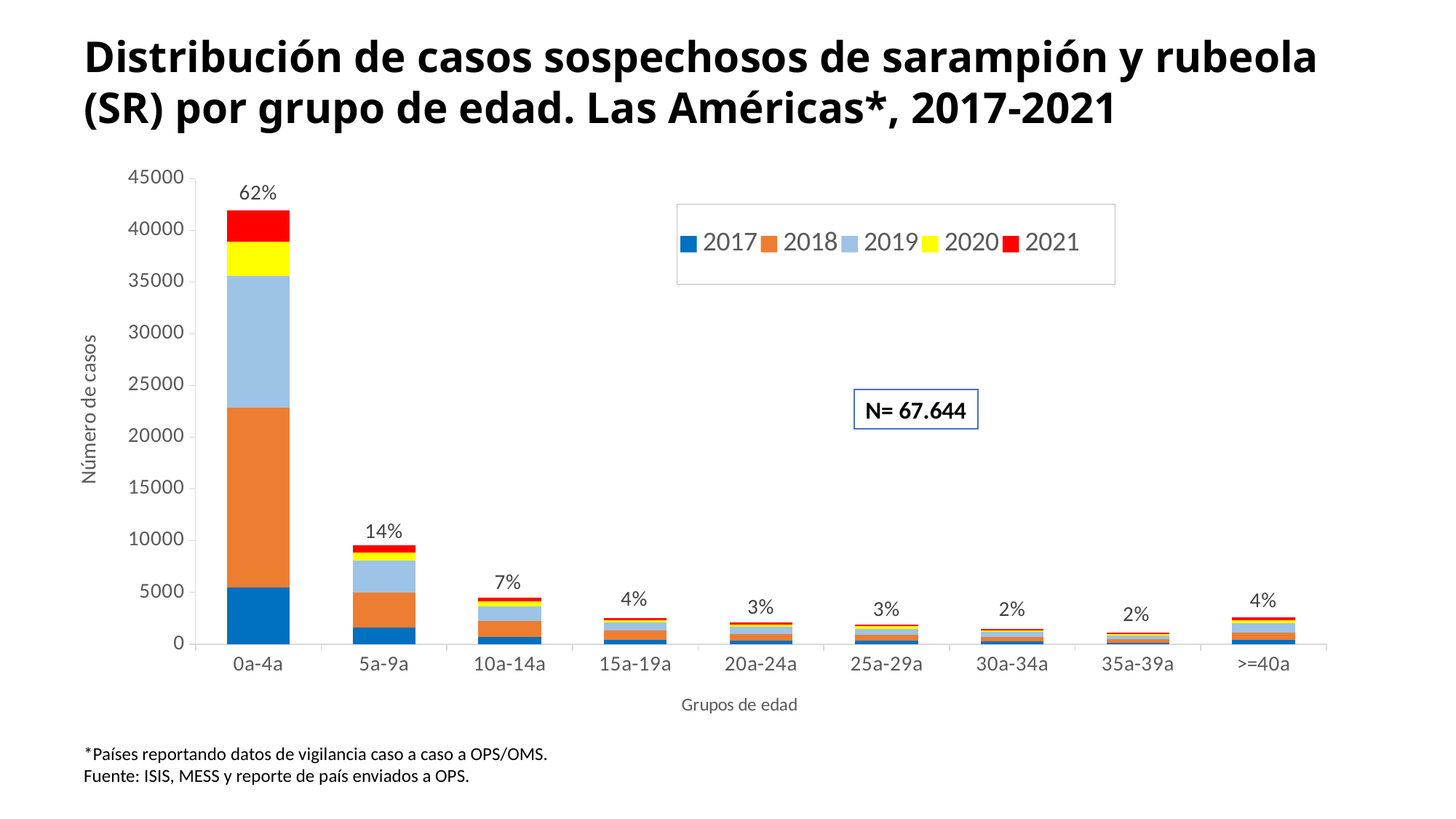
Is the total number of cases for the 0a-4a group greater or less than 40000? greater What total N is shown in the box on the chart? N= 67.644 How many age groups are shown on the x axis? 9 What percentage label is shown above the 5a-9a bar? 14% Which age group has the highest number of cases? 0a-4a What percentage label is shown above the 0a-4a bar? 62% What is the difference between the percentage labels for 0a-4a and 5a-9a? 48% How many years does the legend list? 5 Is the total number of cases for the 10a-14a group greater or less than 5000? less What kind of chart is shown on the slide? stacked bar chart What percentage label is shown above the >=40a bar? 4% Which age group has a larger share of cases, 5a-9a or 10a-14a? 5a-9a